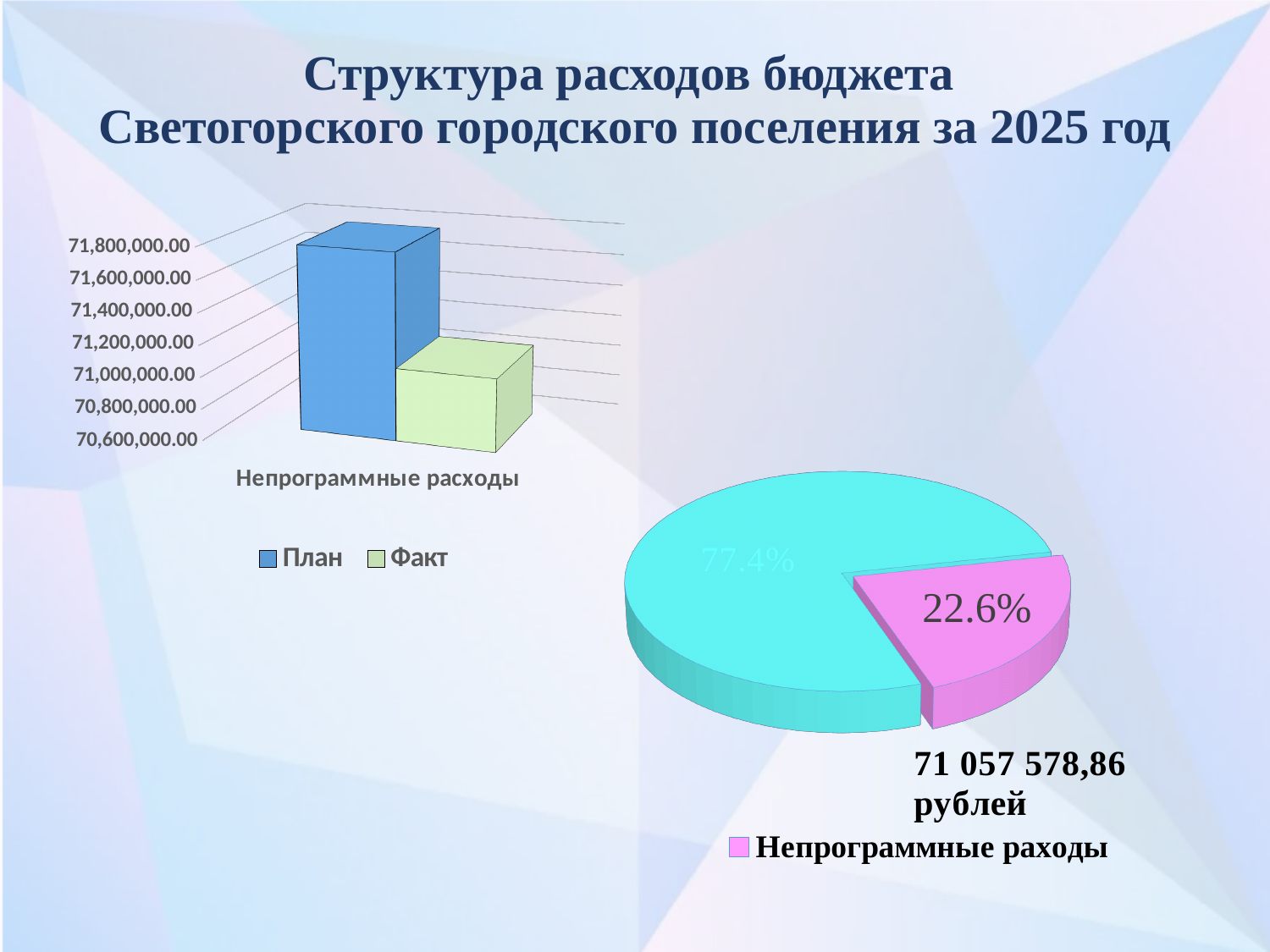
In the pie chart on the right, what share does the pink slice (Непрограммные раходы) have? 22.6% In the pie chart on the right, what share does the larger cyan slice have? 77.4% In the bar chart on the left, which series has the larger value for Непрограммные расходы, План or Факт? План In the bar chart on the left, how many categories are shown on the x axis? 1 In the pie chart on the right, what amount in rubles is printed next to the pink slice? 71 057 578,86 рублей In the bar chart on the left, how many series does the legend list? 2 What kind of chart is the chart on the left of the slide? Bar chart What kind of chart is the chart on the right of the slide? Pie chart In the bar chart on the left, is the value for План greater or less than 71,400,000.00? greater In the bar chart on the left, what are the two legend entries? План, Факт In the bar chart on the left, is the value for Факт greater or less than 71,400,000.00? less In the pie chart on the right, how many slices are there? 2